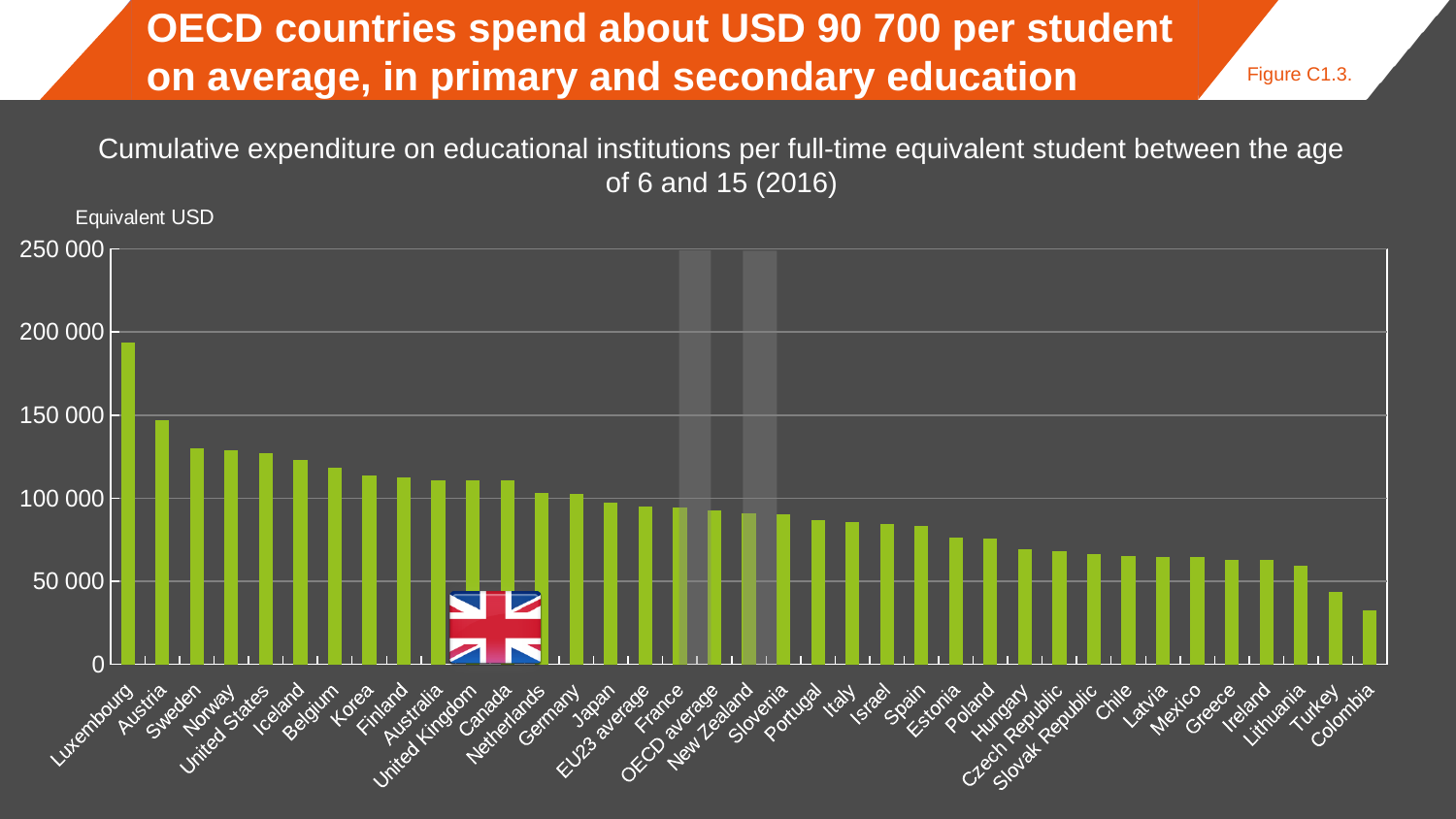
Is the value for Turkey greater or less than 50 000? less What kind of chart is shown on the slide? bar chart Is the value for Colombia greater or less than 50 000? less What unit is shown on the vertical axis label of the chart? Equivalent USD Which country has the highest cumulative expenditure per student in the chart? Luxembourg Do the values generally rise or fall moving from left to right along the x axis? fall Which has a higher value, Norway or Turkey? Norway Which has a higher value, Korea or Spain? Korea Is the value for Sweden greater or less than 100 000? greater Which country has the lowest cumulative expenditure per student in the chart? Colombia